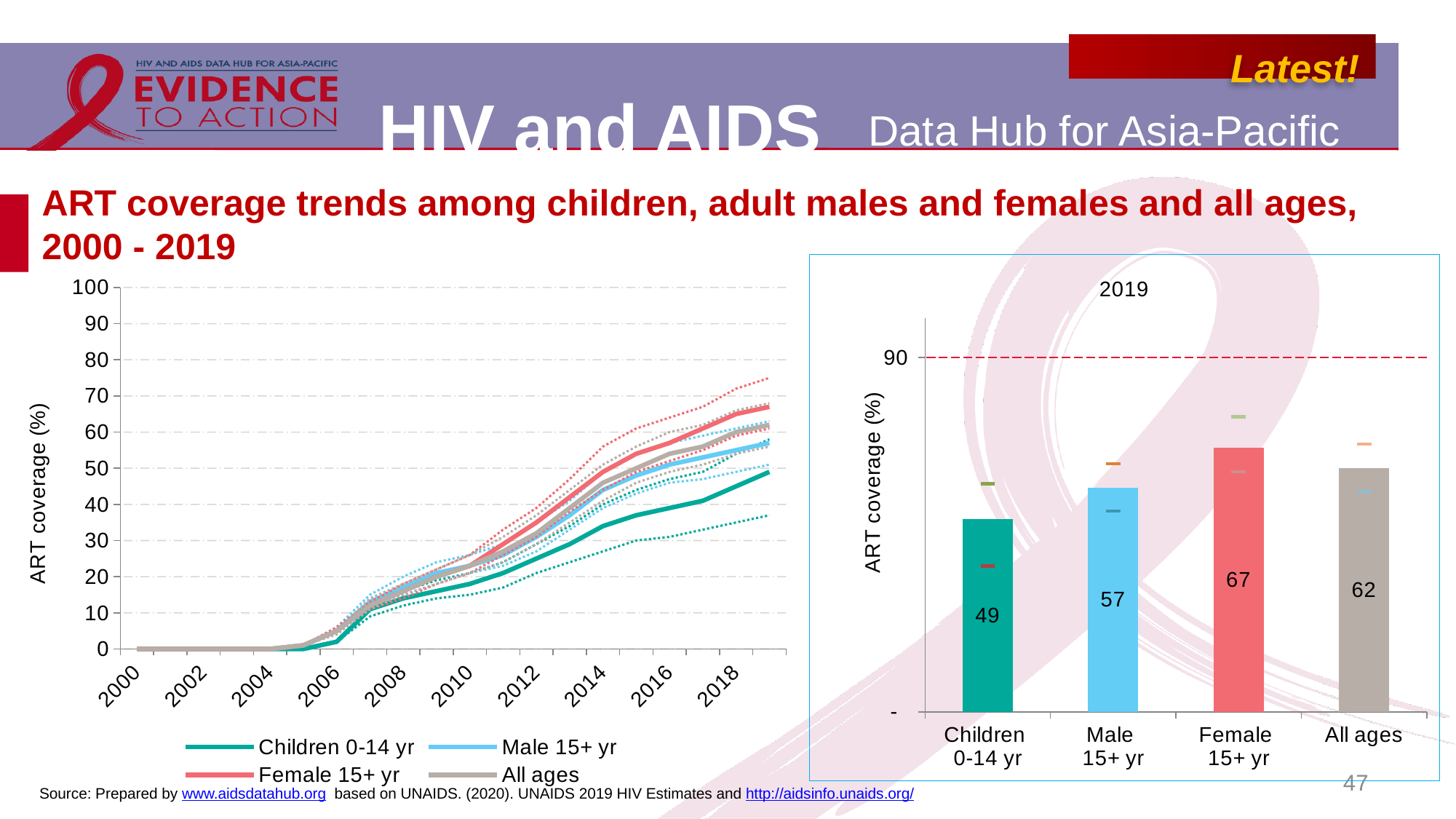
In the 2019 bar chart on the right, which category has the lowest ART coverage? Children 0-14 yr In the 2019 bar chart on the right, which category has the highest ART coverage? Female 15+ yr In the 2019 bar chart on the right, what is the ART coverage for Children 0-14 yr? 49 In the 2019 bar chart on the right, what is the ART coverage for All ages? 62 What type of chart is shown on the left side of the slide? Line chart In the 2019 bar chart on the right, what is the ART coverage for Female 15+ yr? 67 In the 2019 bar chart on the right, is the ART coverage higher for Male 15+ yr or for All ages? All ages In the 2019 bar chart on the right, what value does the dashed horizontal reference line mark? 90 In the 2019 bar chart on the right, what is the difference between the ART coverage for Female 15+ yr and Male 15+ yr? 10 In the line chart on the left, does the ART coverage for Children 0-14 yr rise or fall from 2006 to 2019? Rise In the 2019 bar chart on the right, how many categories are shown? 4 In the line chart on the left, how many series does the legend list? 4